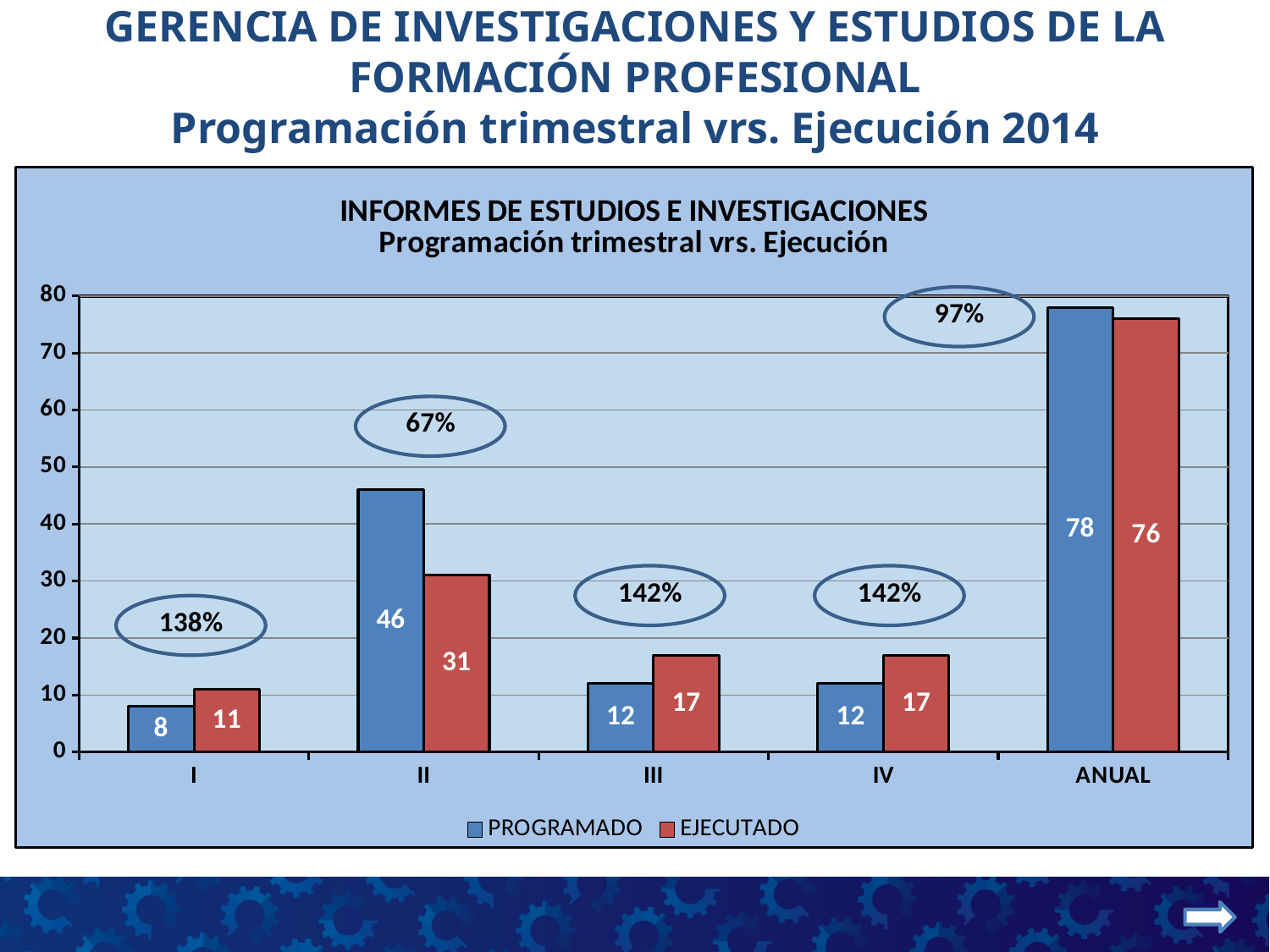
How many series does the legend list? 2 Which is larger for quarter III, PROGRAMADO or EJECUTADO? EJECUTADO Is the PROGRAMADO value for ANUAL greater or less than 70? greater What is the PROGRAMADO value for quarter II? 46 What is the difference between PROGRAMADO and EJECUTADO for quarter II? 15 Which category has the lowest EJECUTADO value? I What is the EJECUTADO value for ANUAL? 76 How many categories are shown on the x axis? 5 Which category has the highest PROGRAMADO value? ANUAL What percentage is shown in the circle above quarter IV? 142% What kind of chart is shown? bar chart What is the EJECUTADO value for quarter I? 11